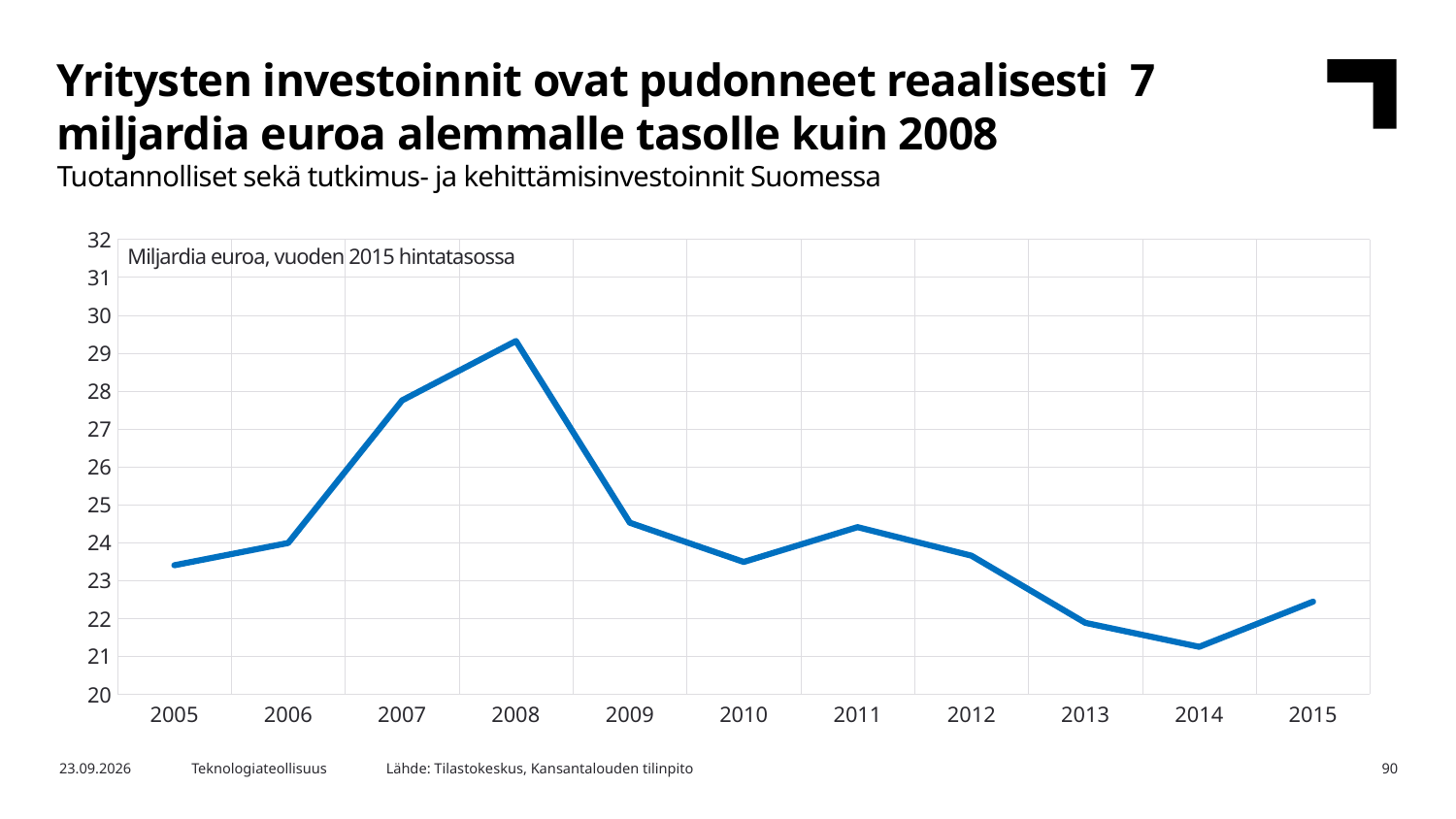
What kind of chart is shown on the slide? line chart Is the value for 2008 greater or less than 29? greater Which is larger, the value for 2007 or the value for 2009? 2007 Is the value for 2007 greater or less than 27? greater Which year has the highest value on the chart? 2008 What unit is stated in the label inside the chart area? Miljardia euroa, vuoden 2015 hintatasossa Do the values rise or fall from 2008 to 2010? fall How many years are plotted on the x axis? 11 Which year has the lowest value on the chart? 2014 Is the value for 2013 greater or less than 23? less Which is larger, the value for 2015 or the value for 2014? 2015